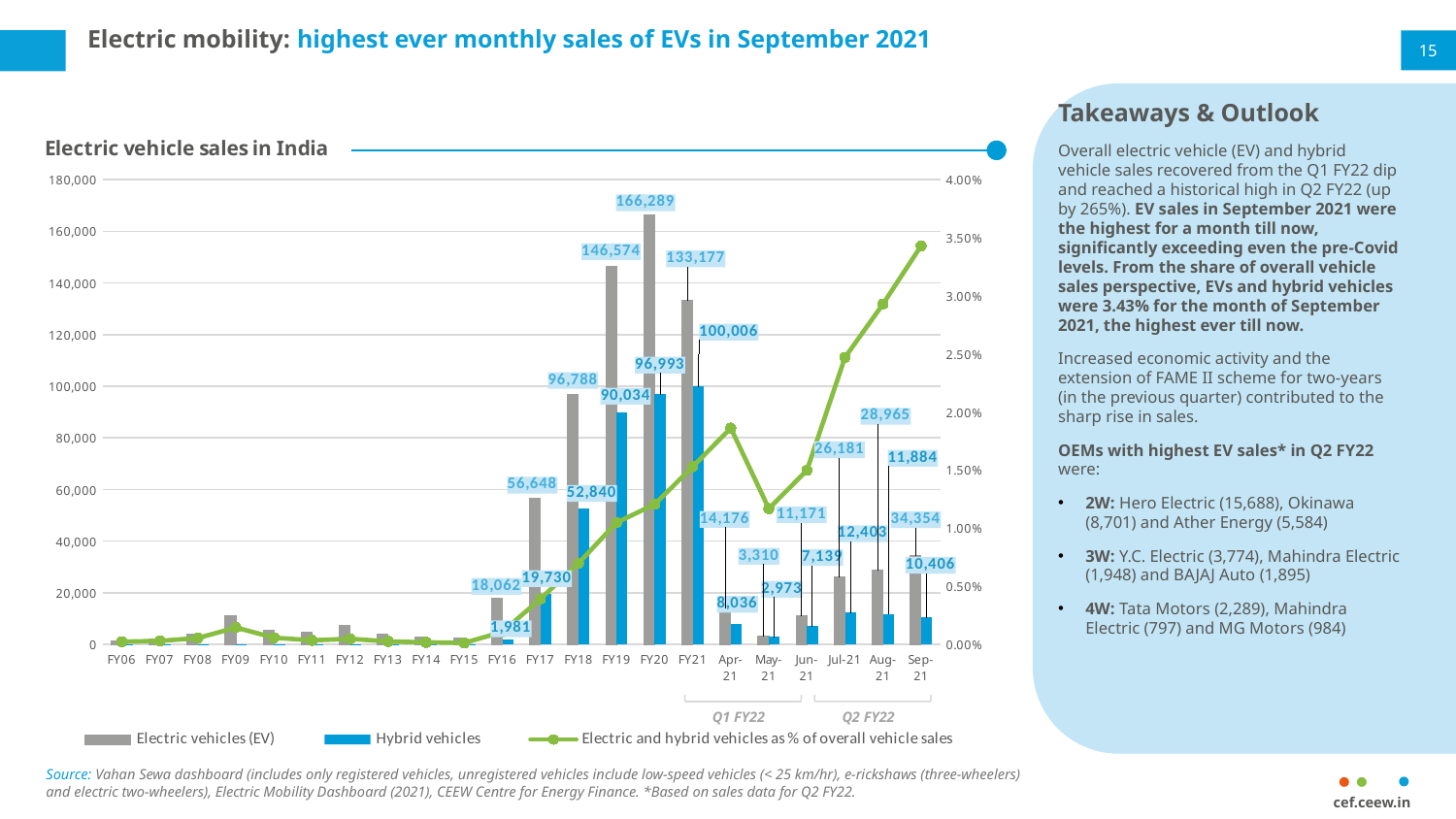
Which is larger, the Electric vehicles (EV) value for Aug-21 or for Sep-21? Sep-21 What is the difference between the Electric vehicles (EV) and Hybrid vehicles values for Sep-21? 23,948 What is the difference between the Electric vehicles (EV) values for FY20 and FY19? 19,715 Which category has the highest value for Electric vehicles (EV)? FY20 What is the value of Hybrid vehicles for May-21? 2,973 What kind of chart is 'Electric vehicle sales in India'? Combination bar and line chart How many series does the legend list? 3 What is the value of Hybrid vehicles for FY21? 100,006 How many categories are shown on the x axis of the chart? 22 Among the monthly categories Apr-21 to Sep-21, which has the lowest value for Electric vehicles (EV)? May-21 What is the value of Electric vehicles (EV) for FY20? 166,289 Is the value of the line 'Electric and hybrid vehicles as % of overall vehicle sales' for Sep-21 greater or less than 3.00%? greater